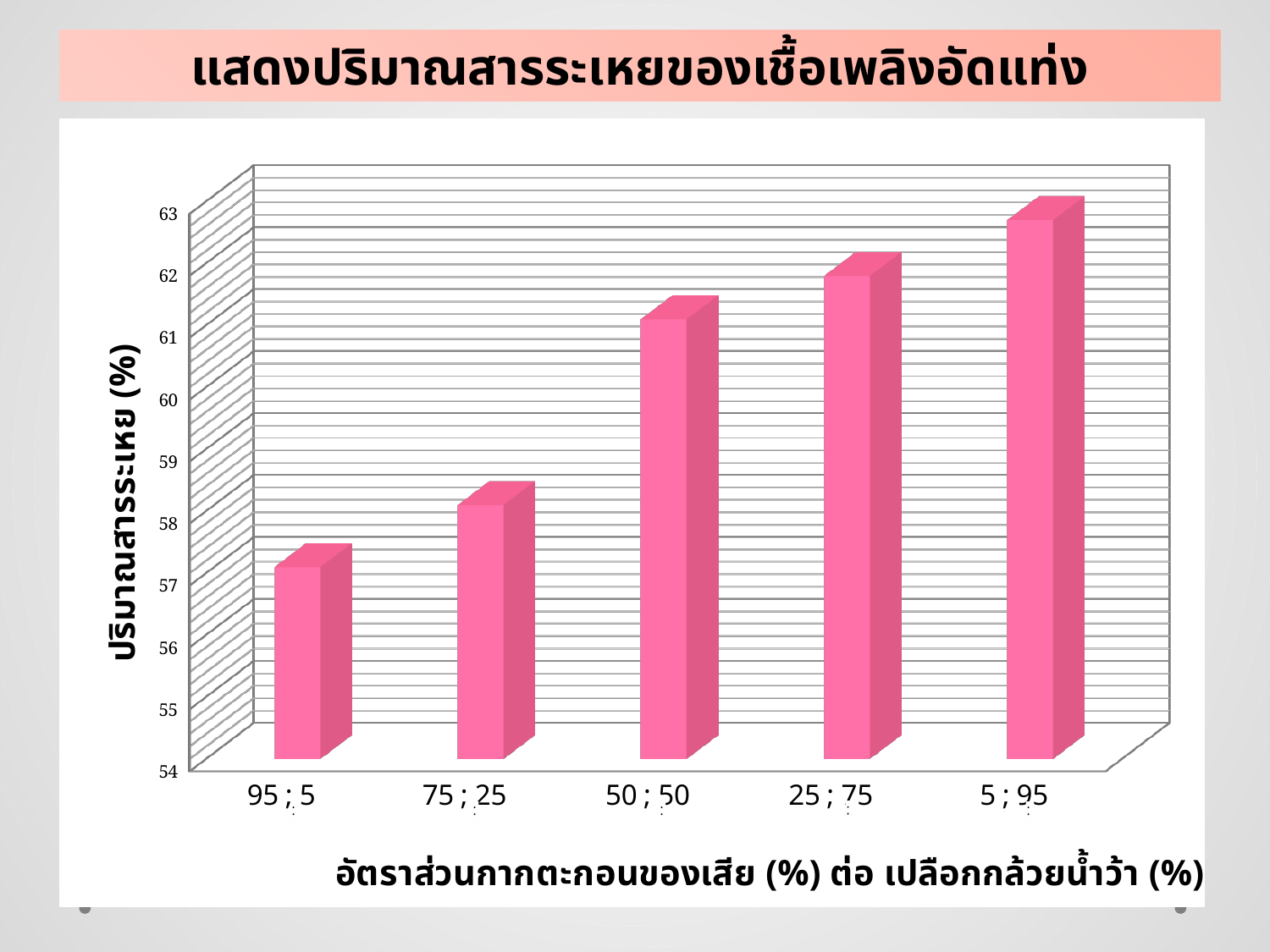
Is the value for 50 ; 50 greater or less than 60? greater Which has a larger value, 25 ; 75 or 95 ; 5? 25 ; 75 Is the value for 75 ; 25 greater or less than 59? less Which has a larger value, 50 ; 50 or 75 ; 25? 50 ; 50 What kind of chart is shown on the slide? bar chart How many categories are shown on the x axis of the chart? 5 Which category has the lowest value in the chart? 95 ; 5 What is the title of the chart's y axis? ปริมาณสารระเหย (%) Is the value for 5 ; 95 greater or less than 62? greater Which category has the highest value in the chart? 5 ; 95 Do the values rise or fall moving from left to right along the x axis? rise